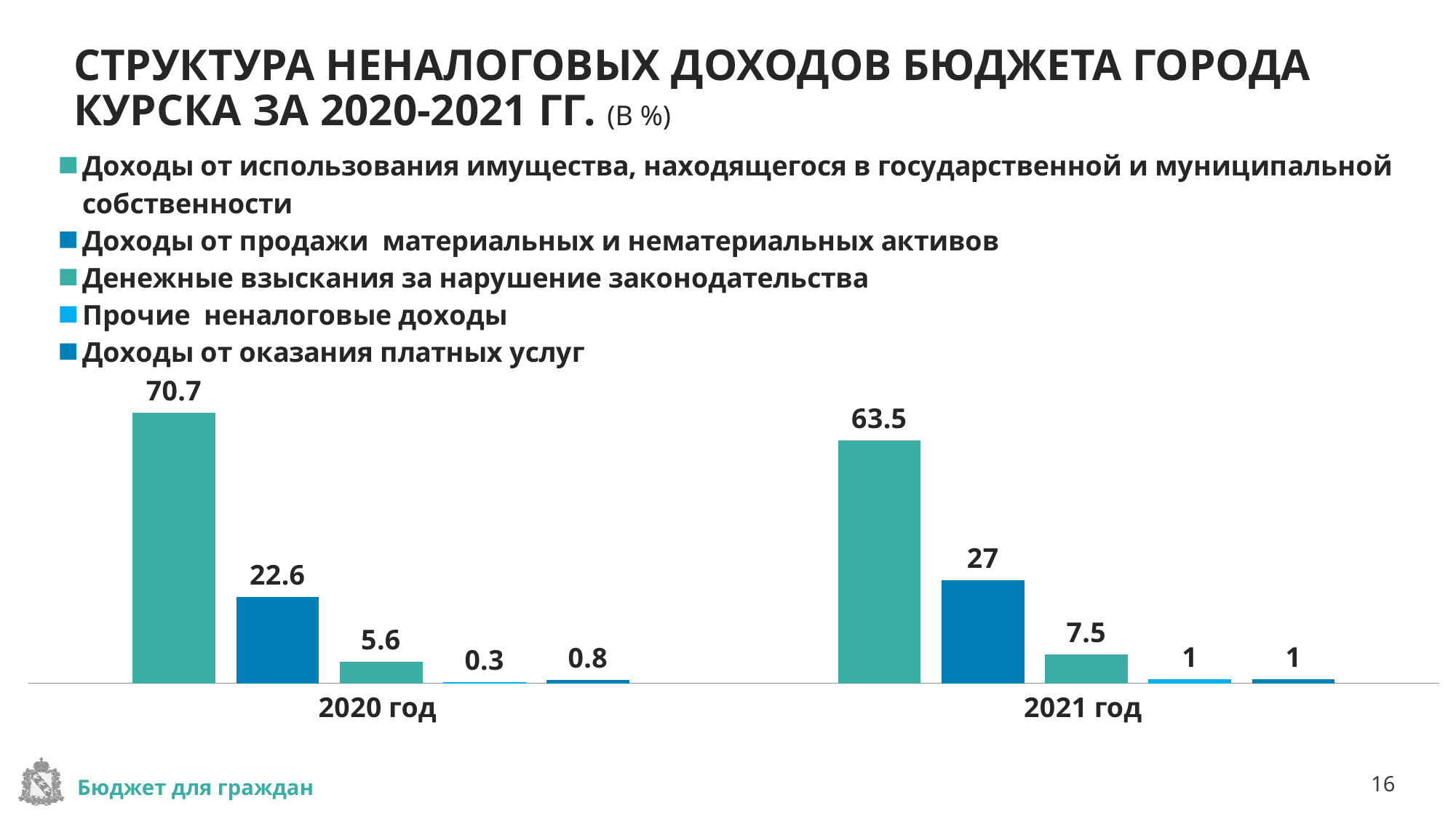
Which is larger: "Доходы от продажи материальных и нематериальных активов" in 2020 год or in 2021 год? 2021 год What kind of chart is shown on the slide? Bar chart How many series does the legend list? 5 What is the value for "Денежные взыскания за нарушение законодательства" in 2020 год? 5.6 Which series has the lowest value in 2020 год? Прочие неналоговые доходы How many year groups are shown on the x axis? 2 What is the value for "Прочие неналоговые доходы" in 2021 год? 1 What is the value for "Доходы от использования имущества, находящегося в государственной и муниципальной собственности" in 2020 год? 70.7 What is the difference between the values for "Доходы от использования имущества, находящегося в государственной и муниципальной собственности" in 2020 год and 2021 год? 7.2 What is the value for "Доходы от оказания платных услуг" in 2020 год? 0.8 What is the value for "Доходы от продажи материальных и нематериальных активов" in 2021 год? 27 Which series has the highest value in 2021 год? Доходы от использования имущества, находящегося в государственной и муниципальной собственности